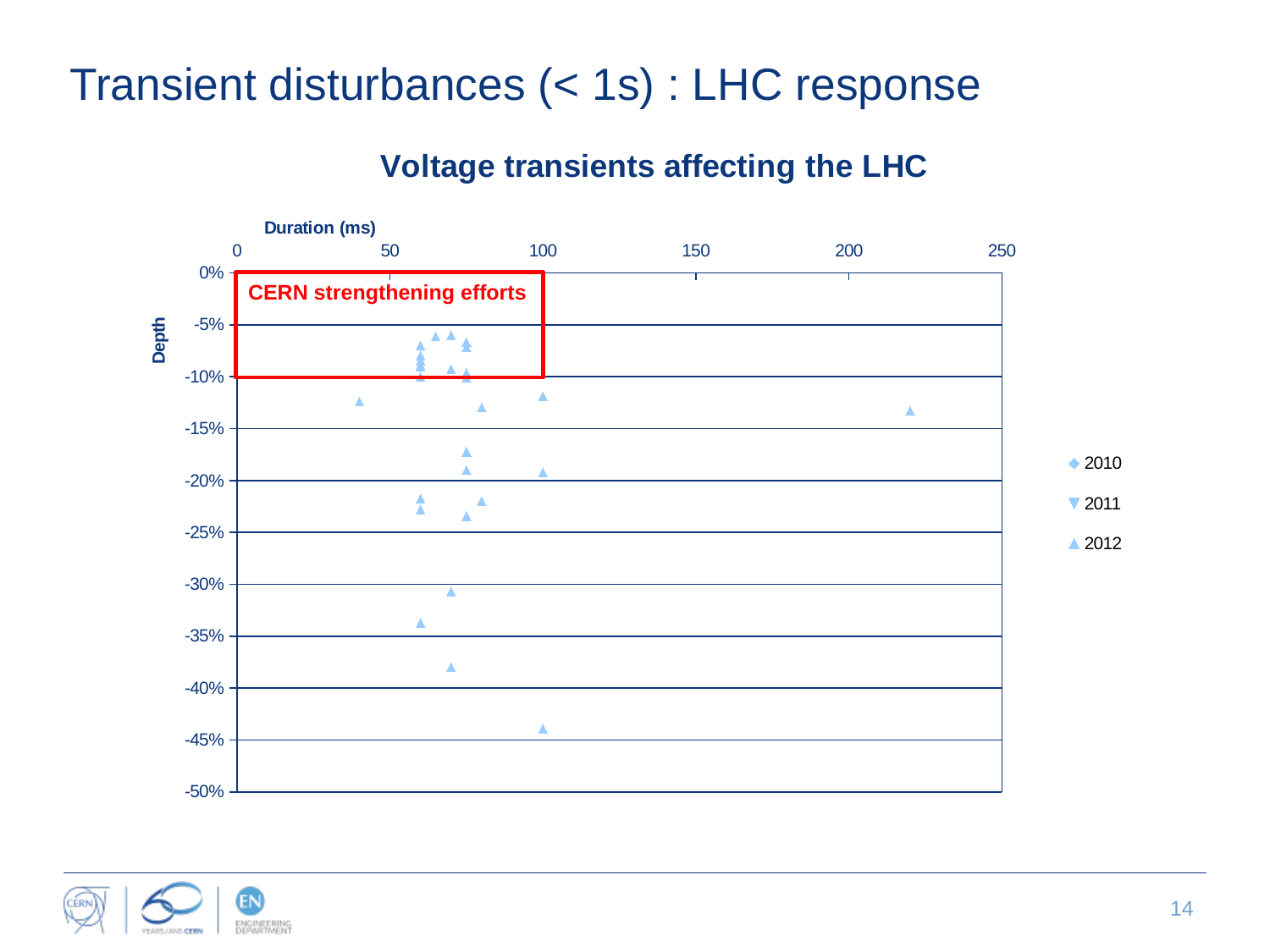
Is the duration of the lowest plotted point (around -44% depth) greater or less than 150 ms? less What is the title of the chart? Voltage transients affecting the LHC Is the depth of the point plotted near 40 ms greater or less than -15%? greater How many series does the legend list? 3 What kind of chart is shown on the slide? scatter chart Is the depth of the point plotted at the longest duration (beyond 200 ms) greater or less than -10%? less What is the label of the horizontal axis? Duration (ms)